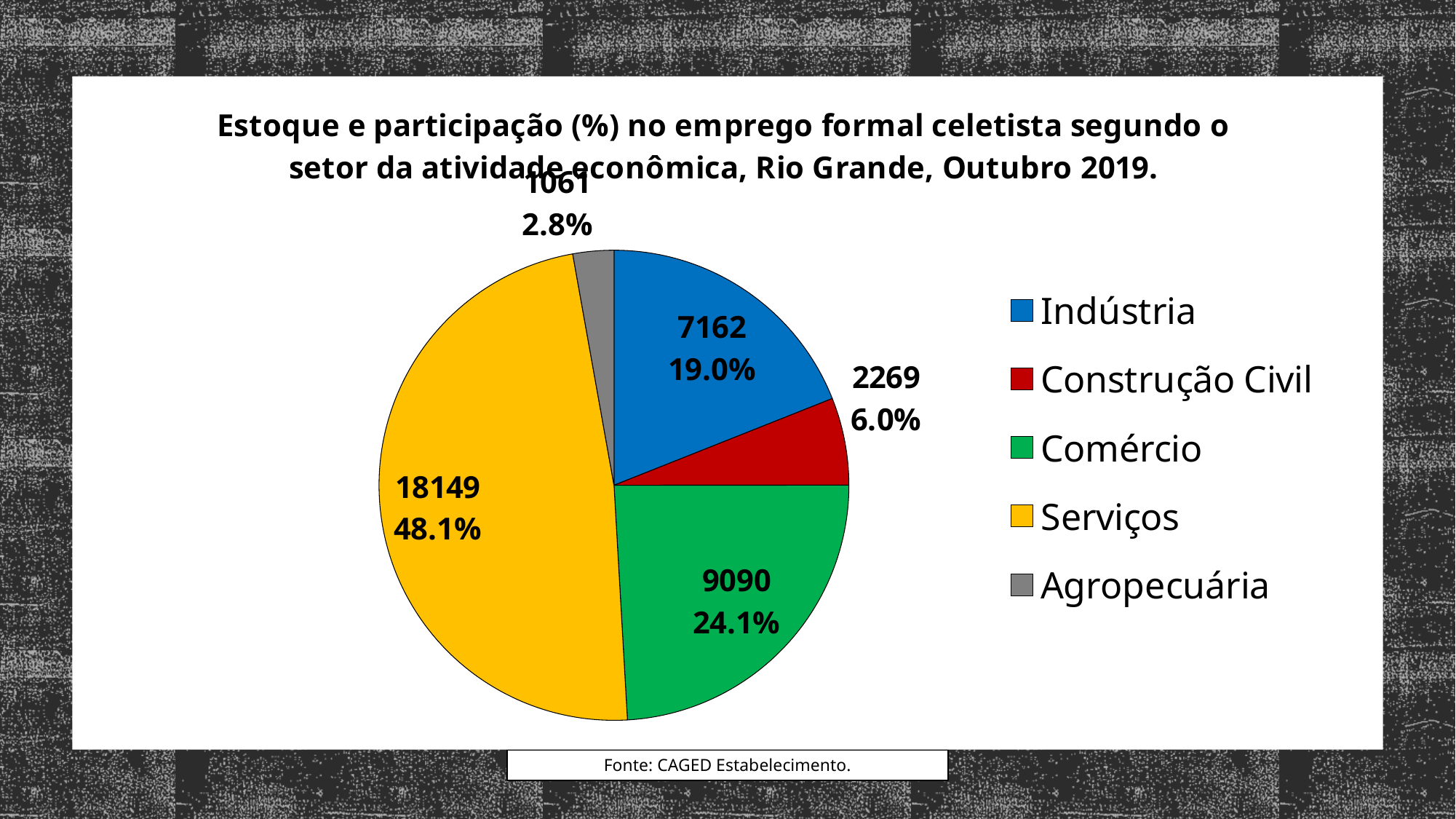
How many sectors does the legend list? 5 Which sector has the largest slice? Serviços What is the value for Serviços? 18149 What share of the pie does Comércio represent? 24.1% What kind of chart is shown on the slide? Pie chart What is the difference between the values for Comércio and Indústria? 1928 What is the value for Indústria? 7162 What share of the pie does Serviços represent? 48.1% Which sector has the smallest slice? Agropecuária What is the value for Construção Civil? 2269 Which is larger, the value for Indústria or the value for Construção Civil? Indústria What is the value for Agropecuária? 1061